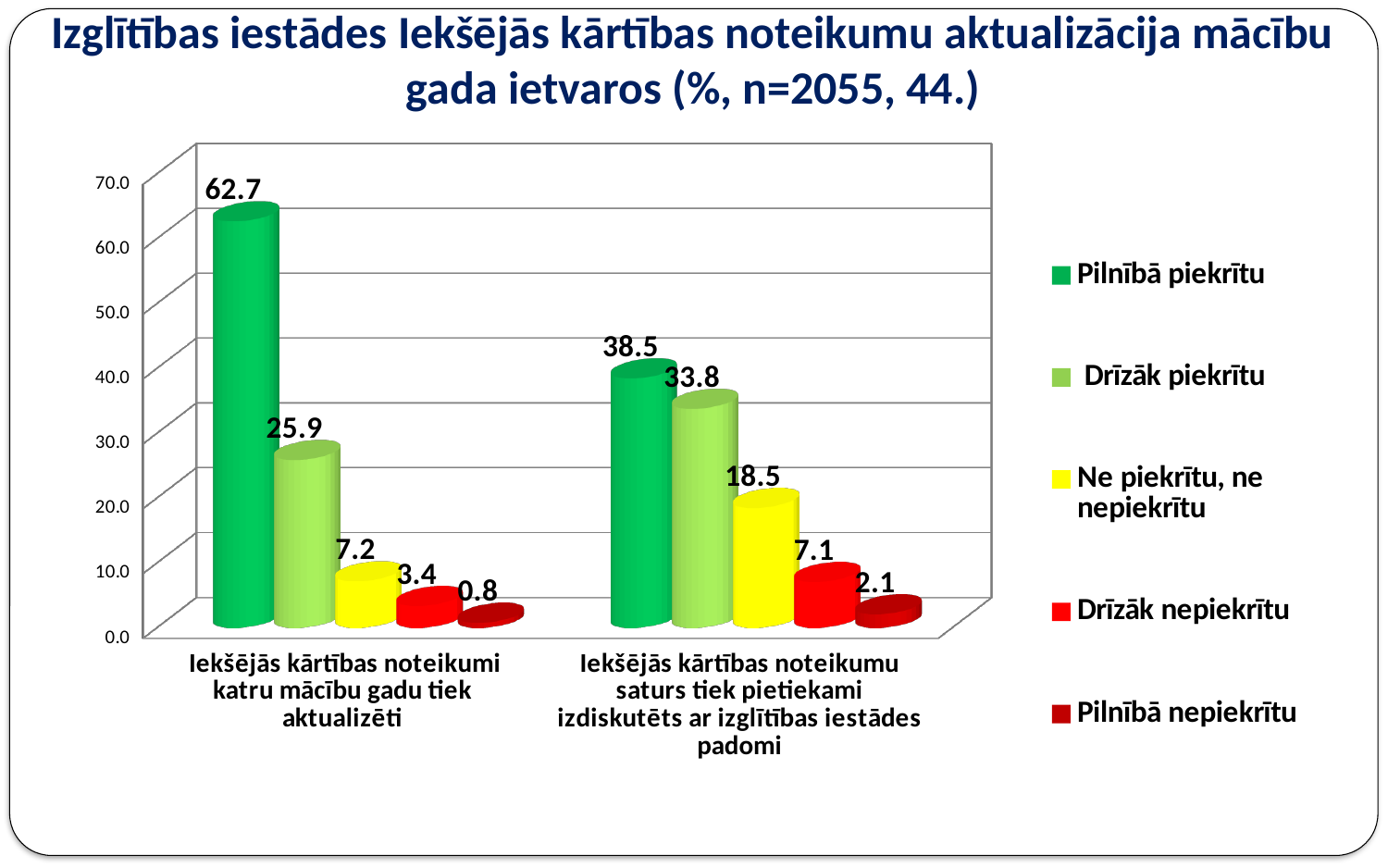
What is the value for "Ne piekrītu, ne nepiekrītu" in the category "Iekšējās kārtības noteikumi katru mācību gadu tiek aktualizēti"? 7.2 Which series has the highest value in the category "Iekšējās kārtības noteikumu saturs tiek pietiekami izdiskutēts ar izglītības iestādes padomi"? Pilnībā piekrītu What is the value for "Pilnībā nepiekrītu" in the category "Iekšējās kārtības noteikumu saturs tiek pietiekami izdiskutēts ar izglītības iestādes padomi"? 2.1 What colour represents "Ne piekrītu, ne nepiekrītu" in the chart? Yellow What is the difference between the "Pilnībā piekrītu" values of the two categories? 24.2 What is the value for "Drīzāk piekrītu" in the category "Iekšējās kārtības noteikumu saturs tiek pietiekami izdiskutēts ar izglītības iestādes padomi"? 33.8 How many categories are shown on the x axis? 2 What is the value for "Pilnībā piekrītu" in the category "Iekšējās kārtības noteikumi katru mācību gadu tiek aktualizēti"? 62.7 How many series does the legend list? 5 Which series has the lowest value in the category "Iekšējās kārtības noteikumi katru mācību gadu tiek aktualizēti"? Pilnībā nepiekrītu What kind of chart is shown on the slide? Bar chart Which category has the larger value for "Drīzāk nepiekrītu"? Iekšējās kārtības noteikumu saturs tiek pietiekami izdiskutēts ar izglītības iestādes padomi